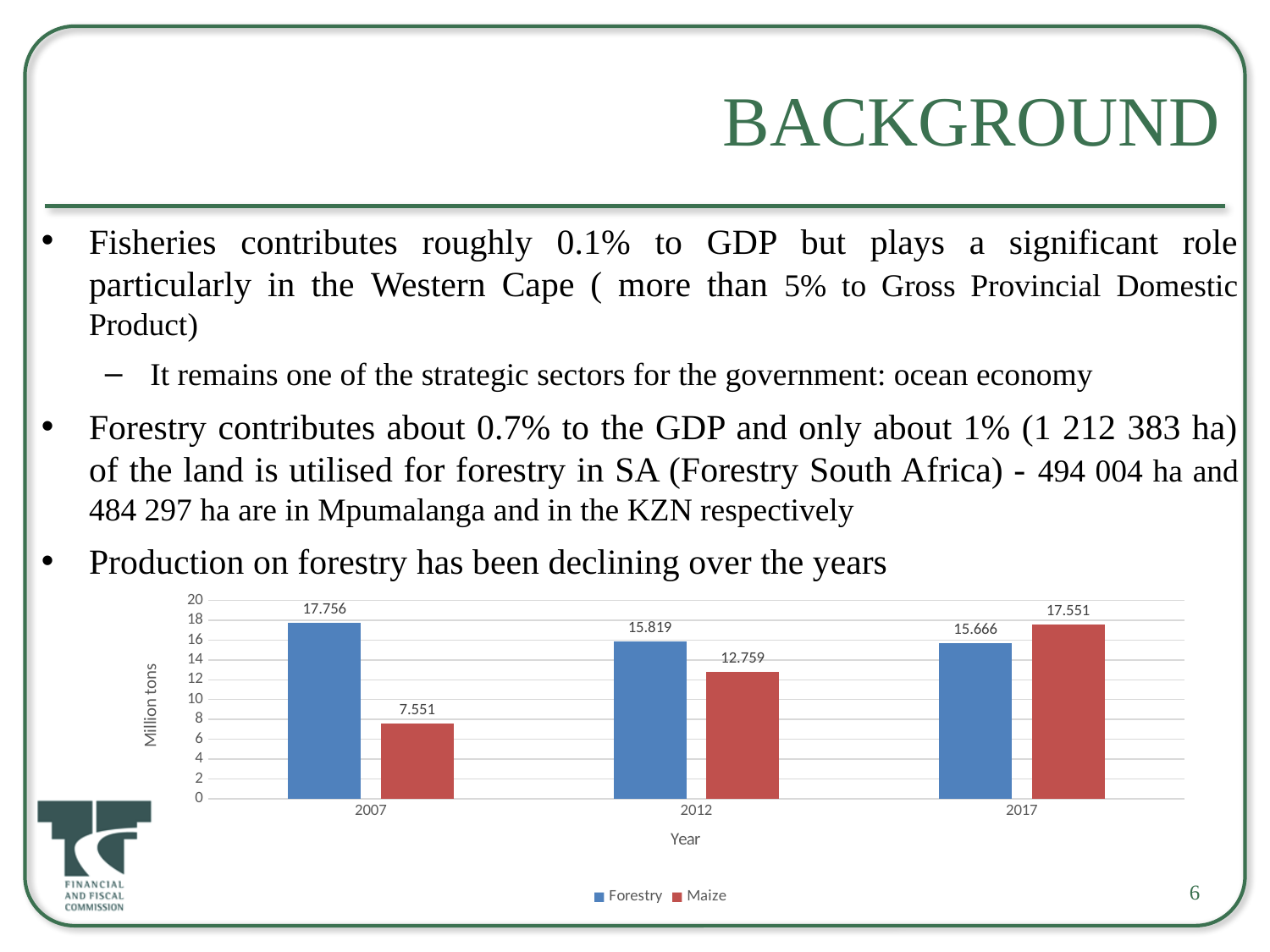
In which year is the Maize value highest? 2017 Is the Maize value for 2007 greater or less than 10? less What kind of chart is shown? bar chart What is the Maize value for 2012? 12.759 What is the Maize value for 2017? 17.551 How many years are shown on the x axis? 3 How many series does the legend list? 2 What is the Forestry value for 2007? 17.756 What is the difference between the Forestry and Maize values in 2007? 10.205 In which year is the Forestry value lowest? 2017 Which is larger in 2012, Forestry or Maize? Forestry Does the Forestry value rise or fall from 2007 to 2017? fall